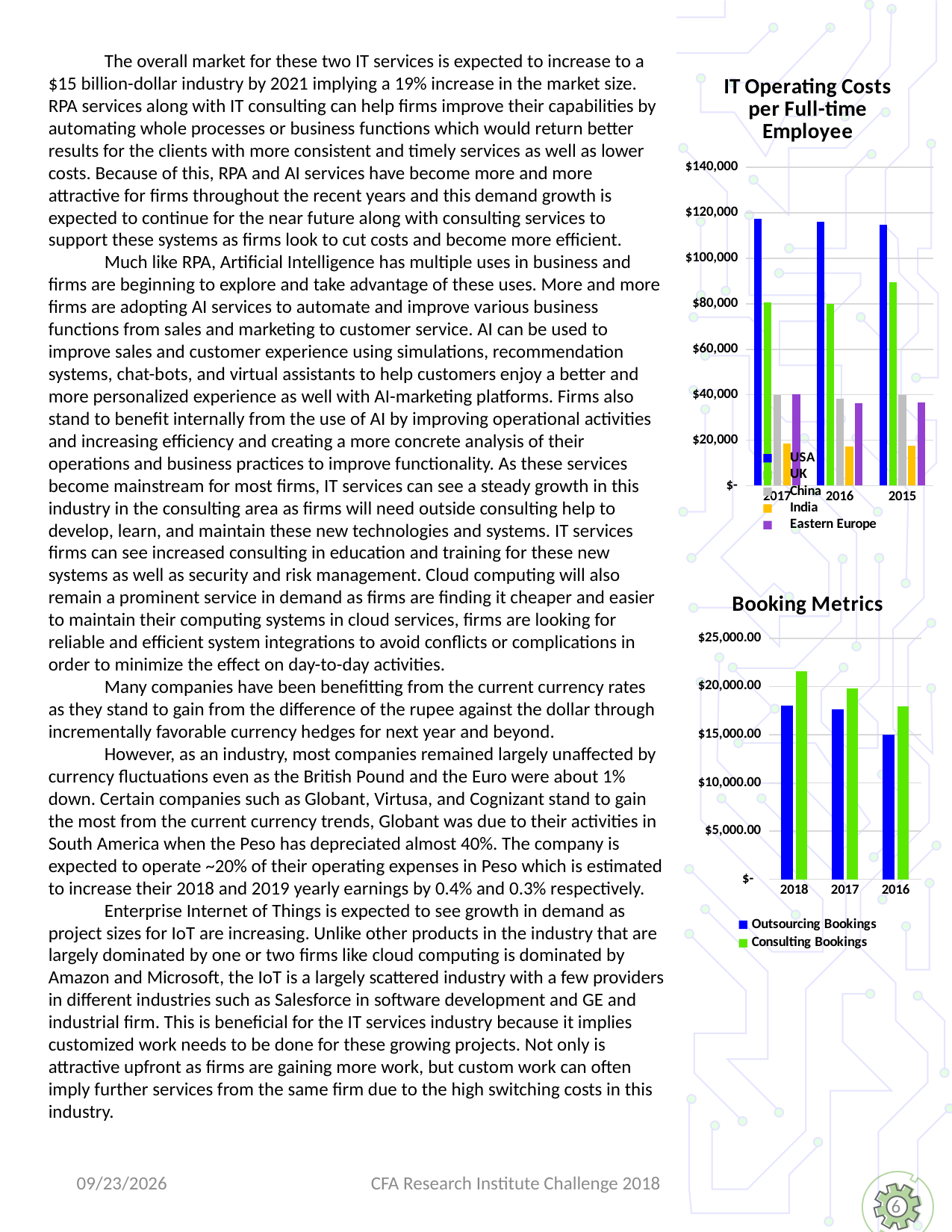
In the "Booking Metrics" chart, which series is larger in 2018, Outsourcing Bookings or Consulting Bookings? Consulting Bookings In the "IT Operating Costs per Full-time Employee" chart, which country has the lowest value in 2017? India In the "IT Operating Costs per Full-time Employee" chart, is the UK value larger in 2015 or in 2017? 2015 How many series does the legend of the "IT Operating Costs per Full-time Employee" chart list? 5 In the "IT Operating Costs per Full-time Employee" chart, is the value for USA in 2017 greater or less than $100,000? greater How many years are shown on the x axis of the "IT Operating Costs per Full-time Employee" chart? 3 What kind of chart is the "Booking Metrics" chart? bar chart In the "IT Operating Costs per Full-time Employee" chart, is the value for UK in 2015 greater or less than $80,000? greater In the "Booking Metrics" chart, is the value for Consulting Bookings in 2018 greater or less than $20,000.00? greater In the "IT Operating Costs per Full-time Employee" chart, which country has the highest value in 2017? USA What kind of chart is the "IT Operating Costs per Full-time Employee" chart? bar chart How many series does the legend of the "Booking Metrics" chart list? 2